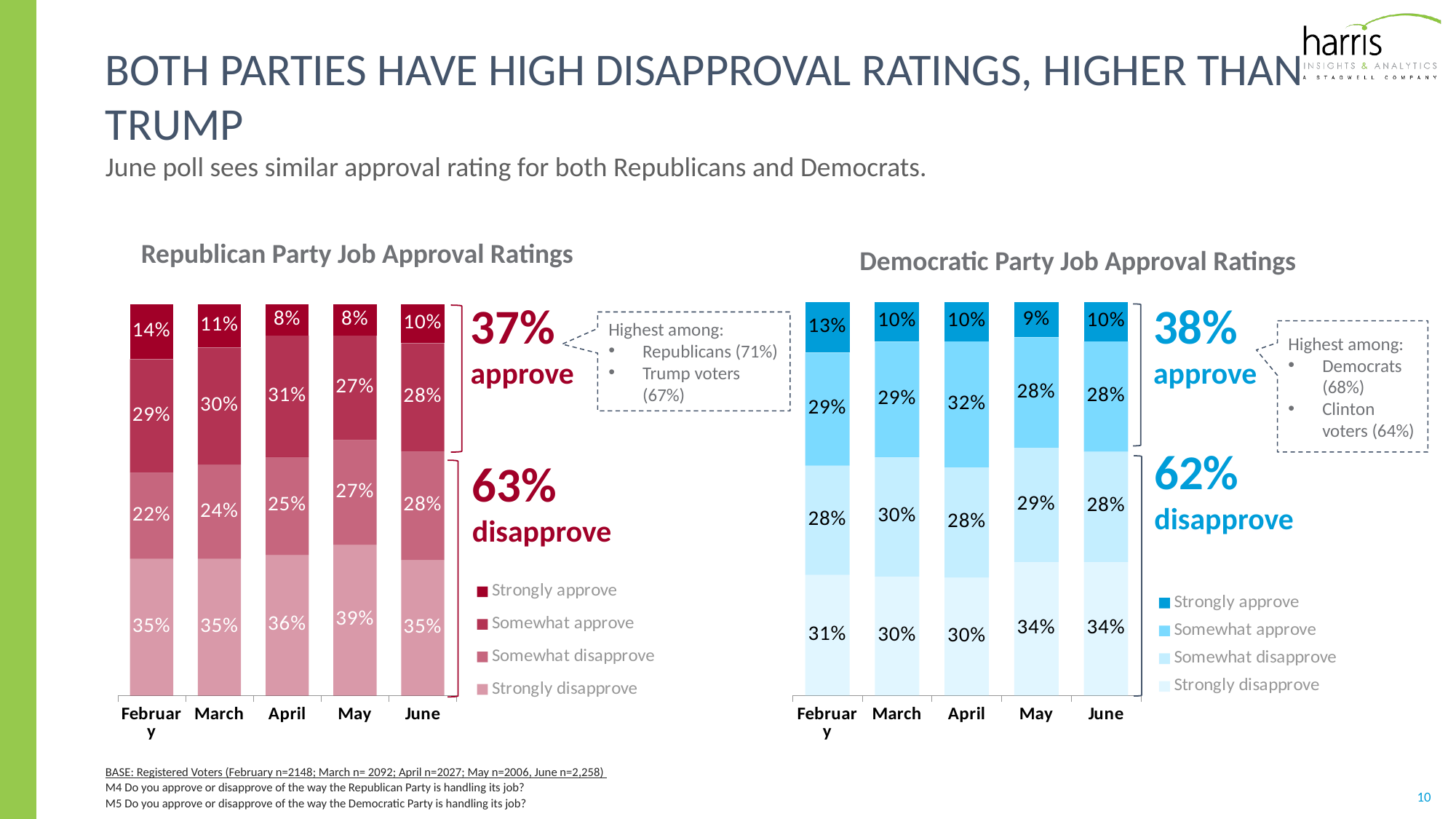
How many series does the legend of the Democratic Party Job Approval Ratings chart list? 4 In the Democratic Party Job Approval Ratings chart, which month has the lowest Strongly approve value? May In the Republican Party Job Approval Ratings chart, does the Strongly approve value rise or fall from February to April? Fall In the Republican Party Job Approval Ratings chart, what is the difference between the Somewhat approve values for April and May? 4% In the Republican Party Job Approval Ratings chart, what is the Strongly approve value for February? 14% How many months are shown on the x axis of the Republican Party Job Approval Ratings chart? 5 In the Republican Party Job Approval Ratings chart, what is the Strongly disapprove value for May? 39% In the Democratic Party Job Approval Ratings chart, is the Strongly disapprove value larger in February or in June? June In the Democratic Party Job Approval Ratings chart, what is the Somewhat approve value for April? 32% In the Democratic Party Job Approval Ratings chart, what is the total of the Strongly approve and Somewhat approve values for June? 38% In the Republican Party Job Approval Ratings chart, which month has the highest Strongly disapprove value? May What type of chart is the Democratic Party Job Approval Ratings chart? Stacked bar chart